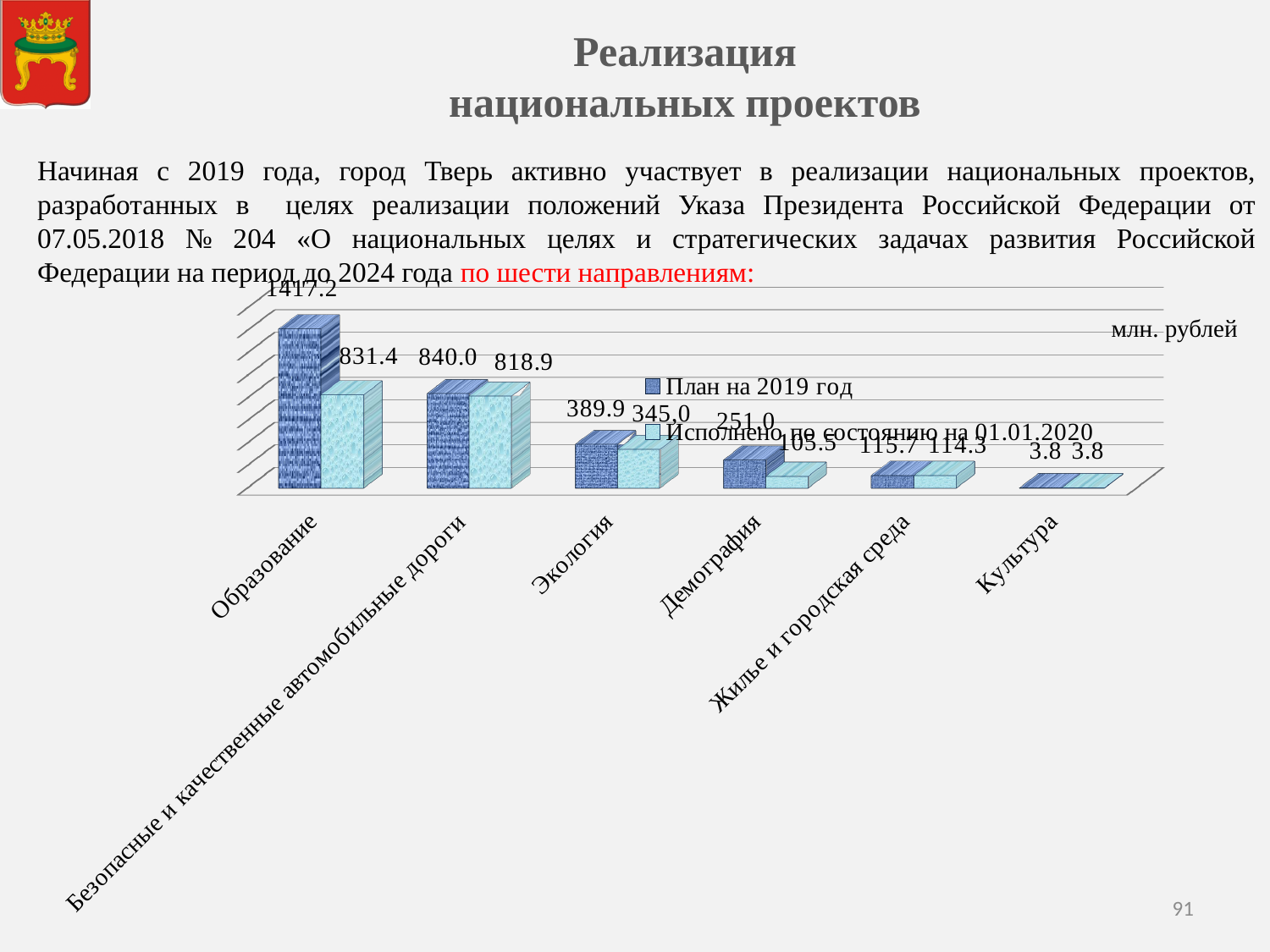
What is the value of 'Исполнено по состоянию на 01.01.2020' for Образование? 831.4 What is the value of 'План на 2019 год' for Образование? 1417.2 Which is larger for Экология: 'План на 2019 год' or 'Исполнено по состоянию на 01.01.2020'? План на 2019 год Which category has the lowest value for 'Исполнено по состоянию на 01.01.2020'? Культура Which category has the highest value for 'План на 2019 год'? Образование What unit of measurement is indicated on the chart? млн. рублей How many categories are shown on the chart's x axis? 6 How many series does the chart legend list? 2 What is the value of 'Исполнено по состоянию на 01.01.2020' for Жилье и городская среда? 114.3 What is the difference between 'План на 2019 год' and 'Исполнено по состоянию на 01.01.2020' for Демография? 147.5 What kind of chart is shown on the slide? bar chart What is the value of 'План на 2019 год' for Демография? 251.0